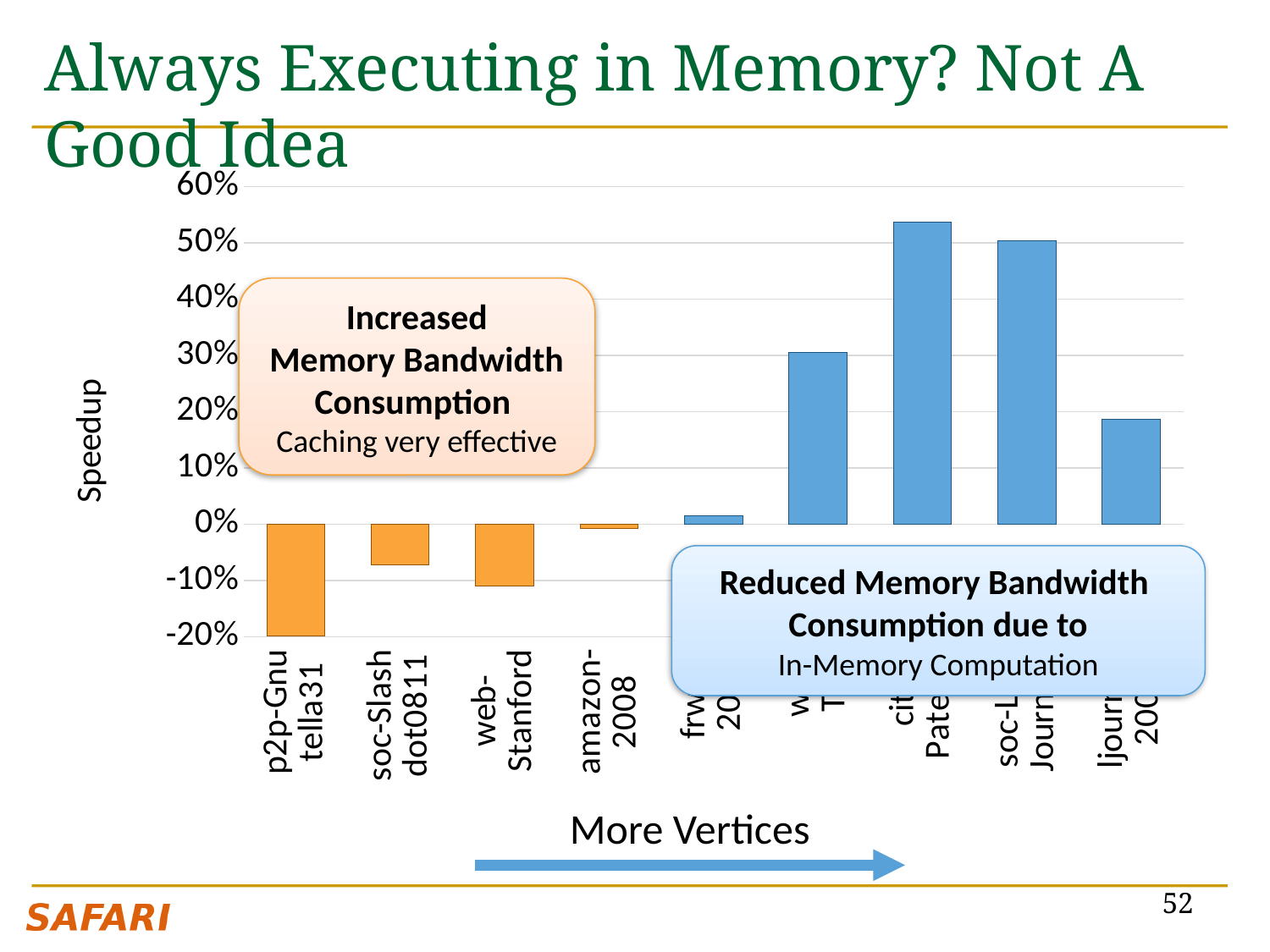
How many bars (categories) are plotted in the chart? 9 Do the speedup values generally rise or fall moving left to right along the x axis (toward more vertices)? rise What is the label of the y axis? Speedup What kind of chart is shown on the slide? bar chart Which has the larger speedup, soc-Slashdot0811 or web-Stanford? soc-Slashdot0811 Is the speedup for p2p-Gnutella31 greater or less than -10%? less Which has the larger speedup, p2p-Gnutella31 or amazon-2008? amazon-2008 What colour are the bars with negative speedup? orange Is the speedup for soc-Slashdot0811 greater or less than -10%? greater Is the speedup for web-Stanford greater or less than 0%? less Which category has the lowest speedup? p2p-Gnutella31